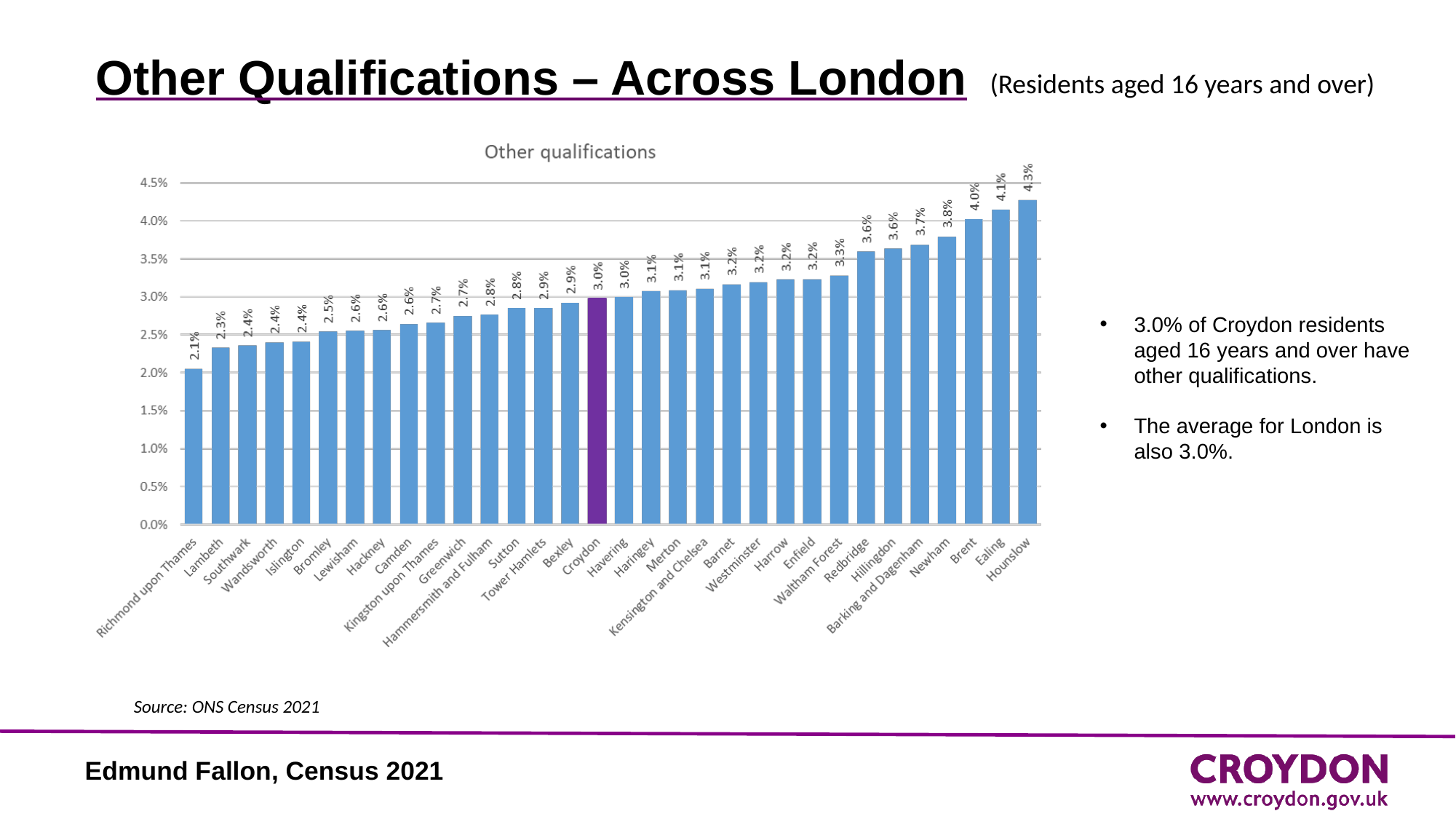
What is the difference between the values for Hounslow and Richmond upon Thames? 2.2% What is the value for Waltham Forest? 3.3% What is the value for Croydon? 3.0% Do the values rise or fall from left to right along the x axis? Rise How many boroughs are shown in the chart? 32 Which is larger, the value for Brent or the value for Newham? Brent What is the value for Hounslow? 4.3% Which borough has the highest value? Hounslow What kind of chart is shown on the slide? Bar chart Which borough's bar is coloured purple instead of blue? Croydon Which borough has the lowest value? Richmond upon Thames Is the value for Lambeth greater or less than 2.5%? less